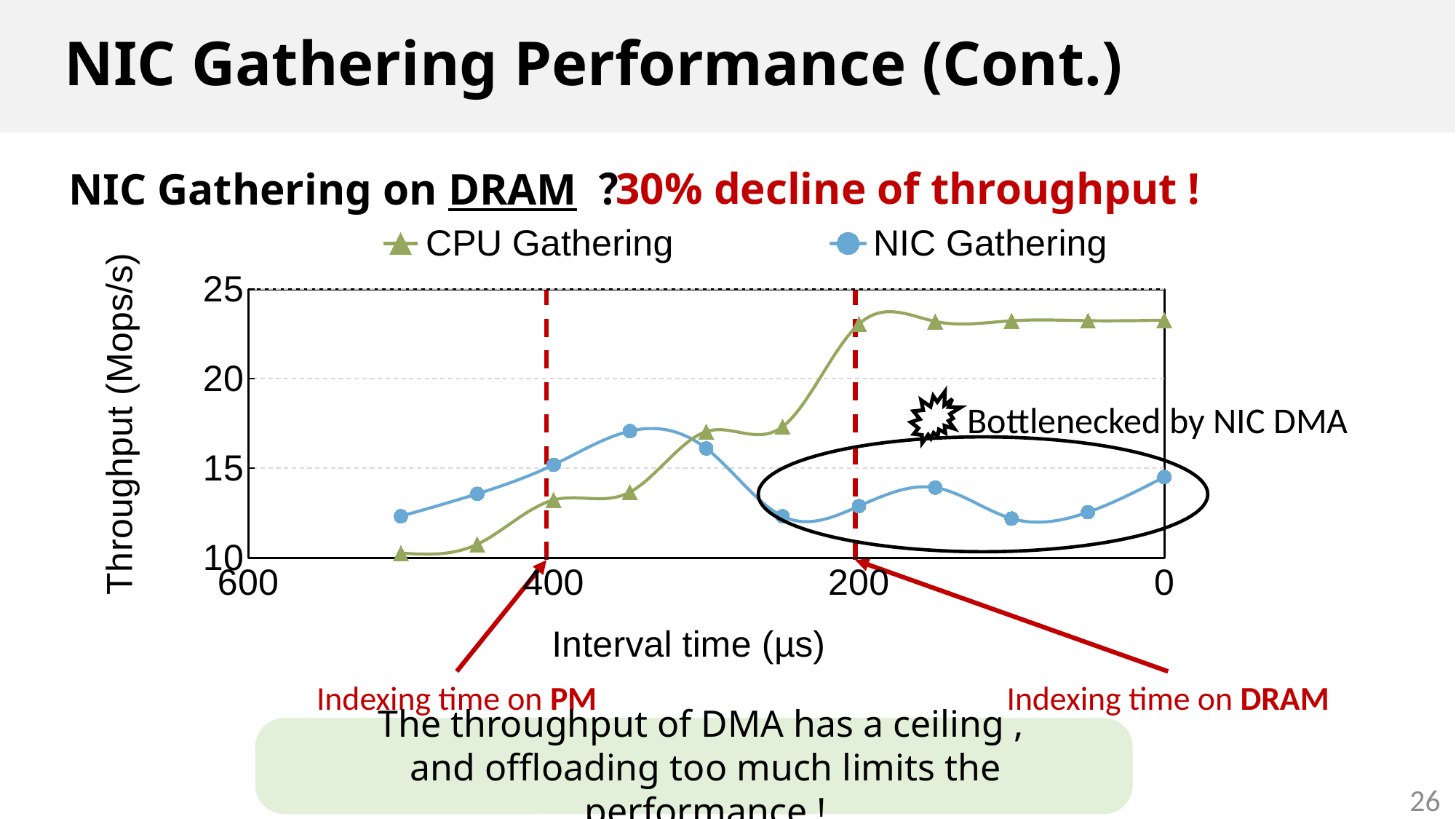
Is the NIC Gathering throughput at an interval time of 0 µs greater or less than 20 Mops/s? less What kind of chart is shown on the slide? Line chart At an interval time of 400 µs, which series has the higher throughput, CPU Gathering or NIC Gathering? NIC Gathering Is the CPU Gathering throughput at an interval time of 500 µs greater or less than 15 Mops/s? less At an interval time of 0 µs, which series has the higher throughput, CPU Gathering or NIC Gathering? CPU Gathering Moving from left to right along the x axis, does the CPU Gathering throughput generally rise or fall? rise How many data points are plotted for the NIC Gathering series? 11 What is the label of the y axis? Throughput (Mops/s) Is the CPU Gathering throughput at an interval time of 0 µs greater or less than 20 Mops/s? greater How many series does the legend list? 2